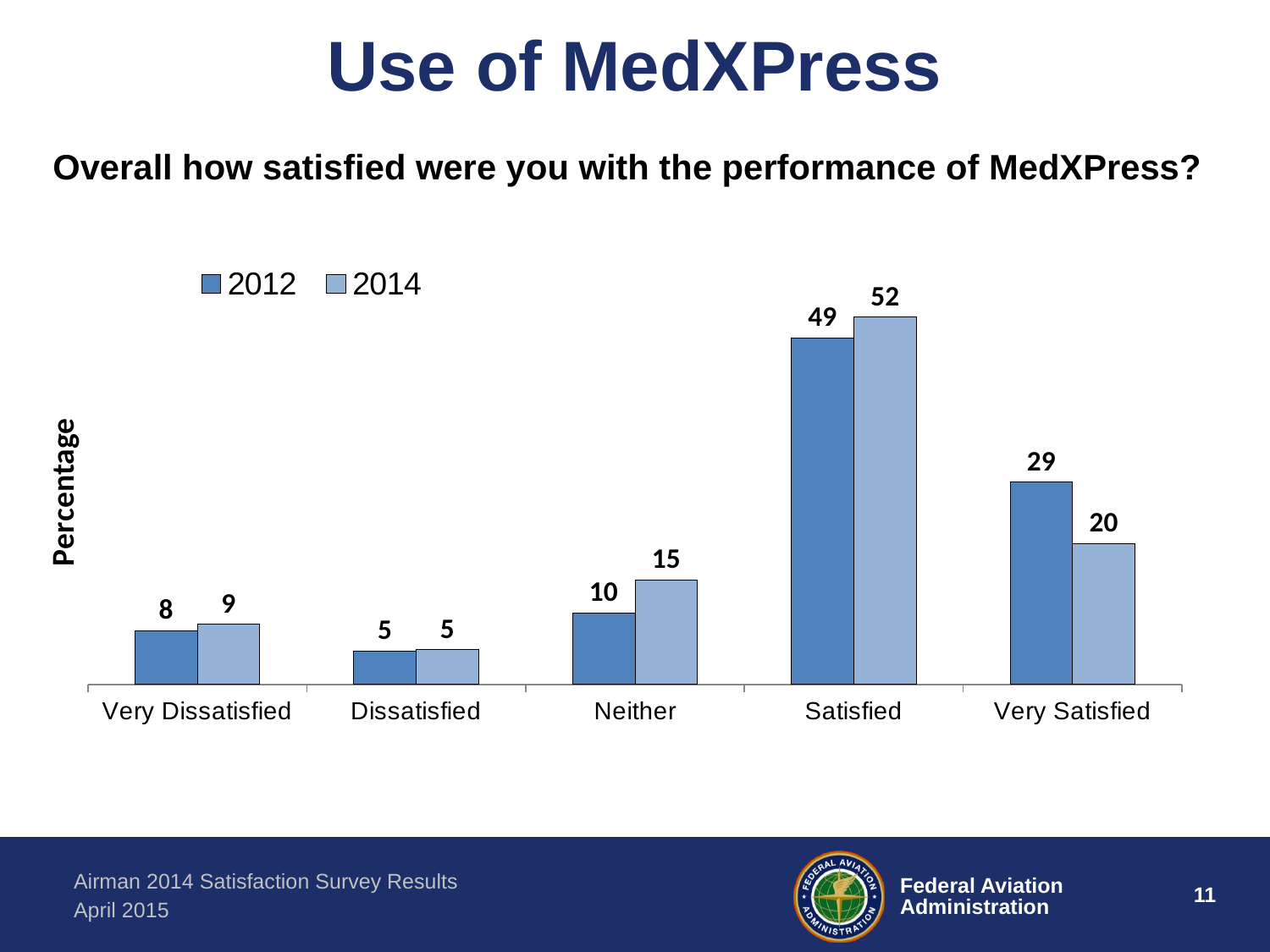
What are the two series listed in the legend? 2012 and 2014 Which category has the highest 2012 value? Satisfied What kind of chart is shown on the slide? Bar chart What is the 2014 value for Neither? 15 What is the 2012 value for Very Satisfied? 29 What is the label of the y axis? Percentage Which is larger for Neither, the 2012 value or the 2014 value? 2014 What is the 2014 value for Satisfied? 52 Which category has the lowest 2014 value? Dissatisfied How many series does the legend list? 2 What is the difference between the 2012 and 2014 values for Very Satisfied? 9 How many categories are shown on the x axis? 5